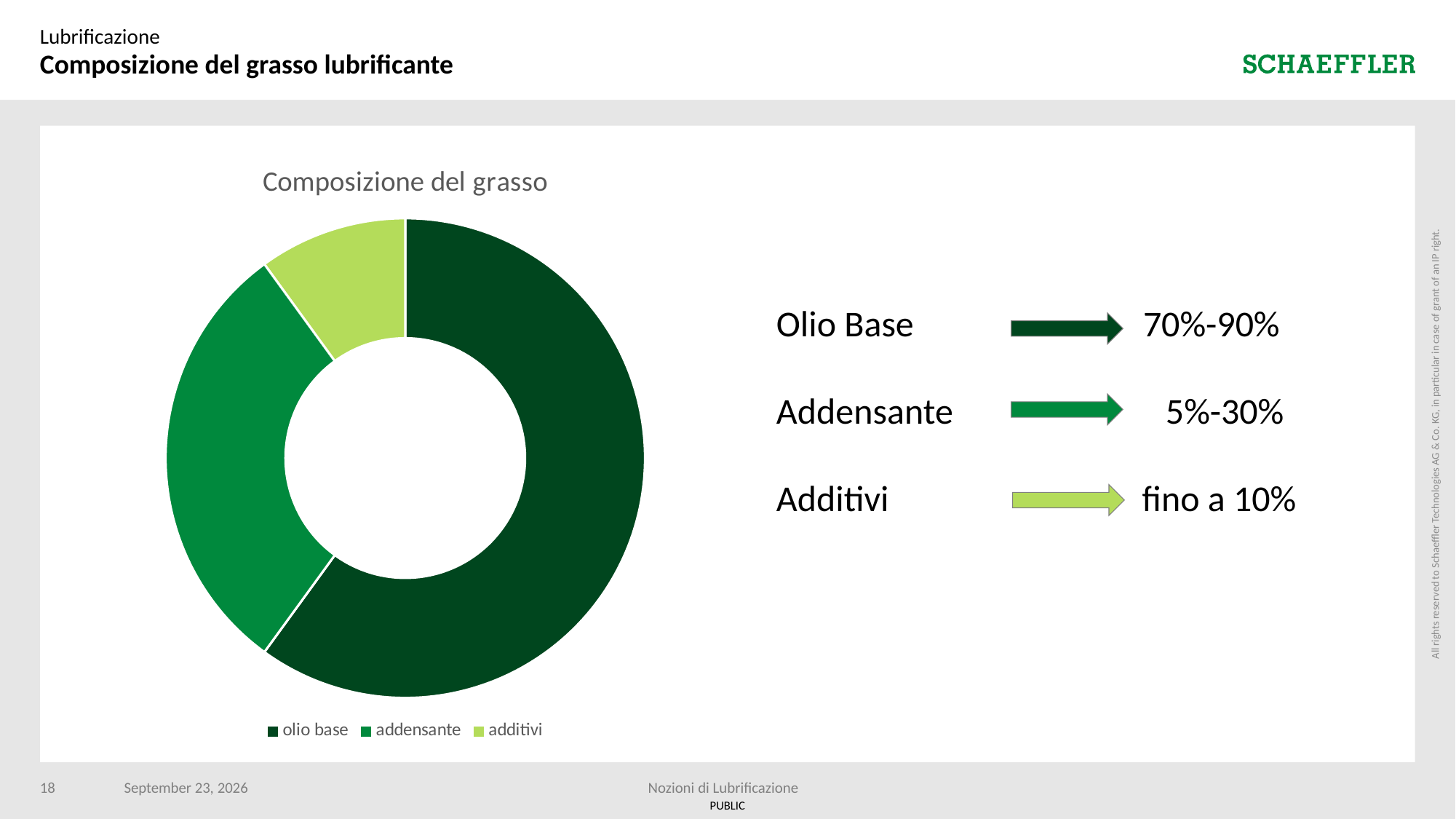
Which slice is larger, olio base or addensante? olio base How many entries does the chart legend list? 3 What is the title of the chart? Composizione del grasso How many slices does the doughnut chart have? 3 What kind of chart is shown on the slide? Doughnut chart Which legend entry is shown in the lightest green colour? additivi Which slice is larger, addensante or additivi? addensante Which category has the largest slice in the doughnut chart? olio base Is the olio base slice more or less than half of the doughnut chart? more Which category has the smallest slice in the doughnut chart? additivi